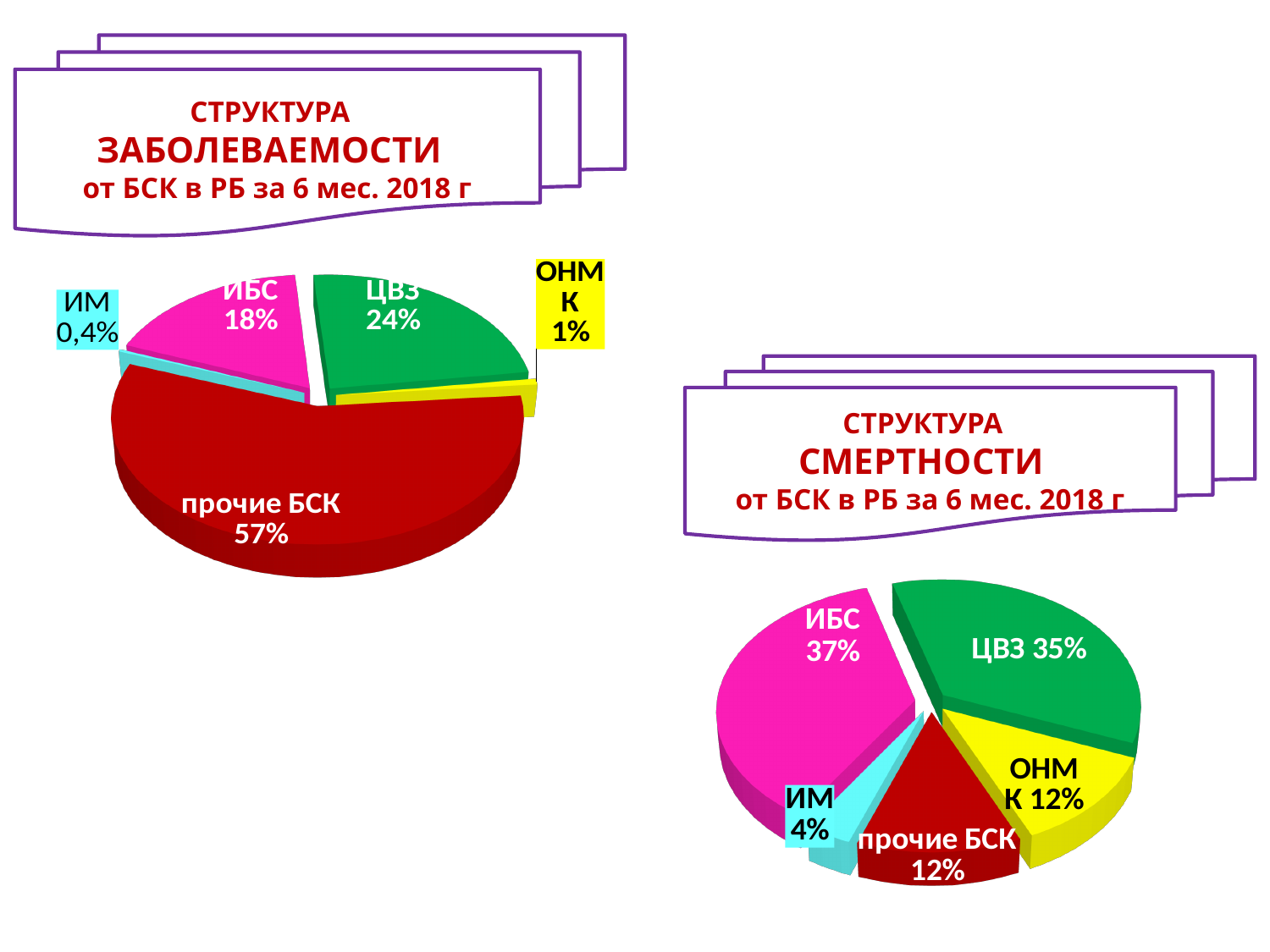
In the chart titled 'СТРУКТУРА СМЕРТНОСТИ от БСК в РБ за 6 мес. 2018 г', which category has the smallest share? ИМ In the chart titled 'СТРУКТУРА ЗАБОЛЕВАЕМОСТИ от БСК в РБ за 6 мес. 2018 г', which category has the smallest share? ИМ In the chart titled 'СТРУКТУРА СМЕРТНОСТИ от БСК в РБ за 6 мес. 2018 г', what share does 'ОНМК' have? 12% In the chart titled 'СТРУКТУРА ЗАБОЛЕВАЕМОСТИ от БСК в РБ за 6 мес. 2018 г', how many slices does the pie have? 5 In the chart titled 'СТРУКТУРА СМЕРТНОСТИ от БСК в РБ за 6 мес. 2018 г', which is larger, 'ИБС' or 'ЦВЗ'? ИБС In the chart titled 'СТРУКТУРА ЗАБОЛЕВАЕМОСТИ от БСК в РБ за 6 мес. 2018 г', what share does 'ИМ' have? 0,4% What kind of chart is used for 'СТРУКТУРА СМЕРТНОСТИ от БСК в РБ за 6 мес. 2018 г'? Pie chart In the chart titled 'СТРУКТУРА СМЕРТНОСТИ от БСК в РБ за 6 мес. 2018 г', what share does 'ИБС' have? 37% In the chart titled 'СТРУКТУРА СМЕРТНОСТИ от БСК в РБ за 6 мес. 2018 г', what colour is the 'ЦВЗ' slice? Green In the chart titled 'СТРУКТУРА ЗАБОЛЕВАЕМОСТИ от БСК в РБ за 6 мес. 2018 г', which category has the largest share? прочие БСК In the chart titled 'СТРУКТУРА ЗАБОЛЕВАЕМОСТИ от БСК в РБ за 6 мес. 2018 г', how many percentage points larger is 'ЦВЗ' than 'ИБС'? 6 In the chart titled 'СТРУКТУРА ЗАБОЛЕВАЕМОСТИ от БСК в РБ за 6 мес. 2018 г', what share does 'прочие БСК' have? 57%